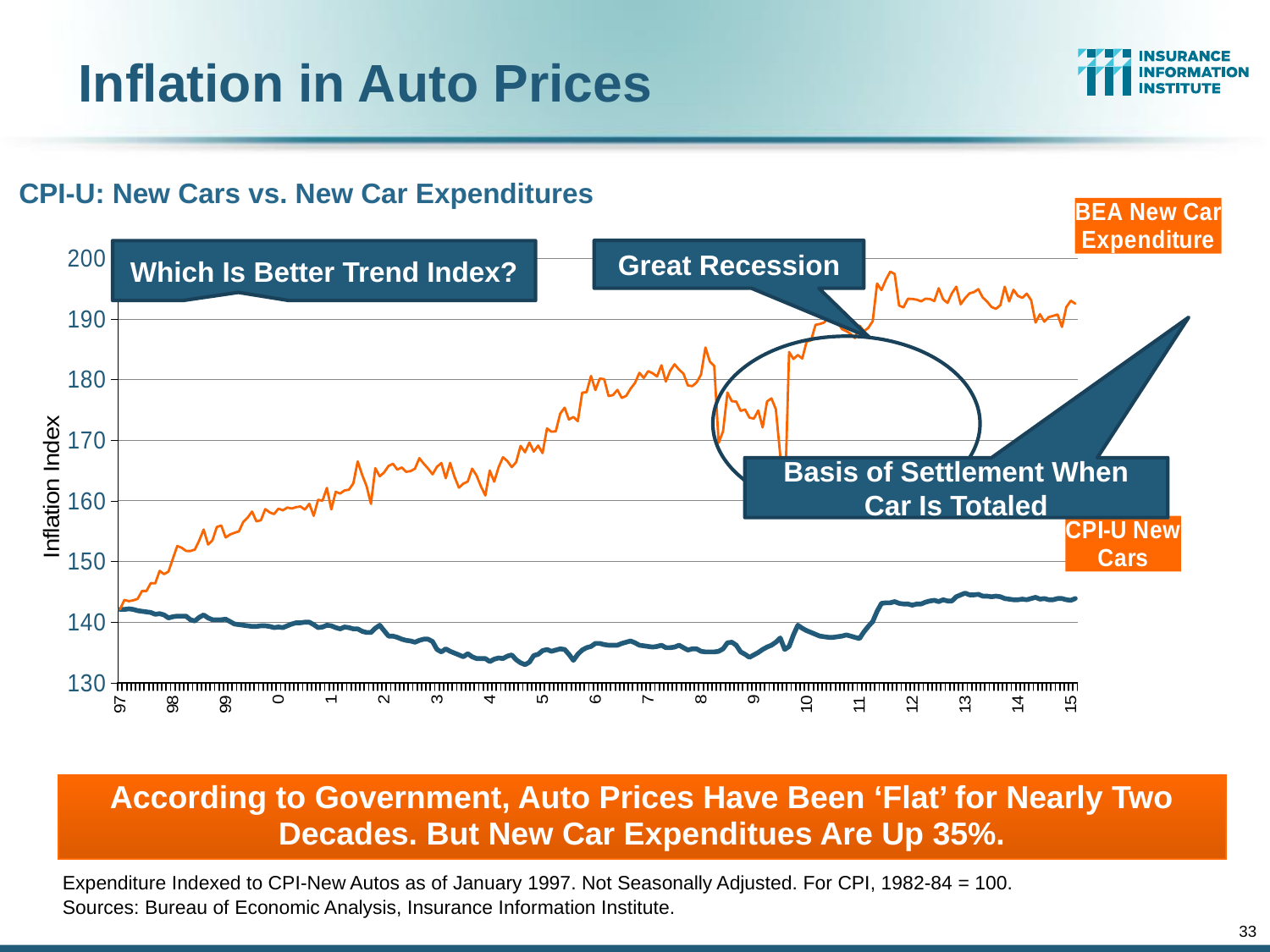
What kind of chart is shown on the slide? Line chart Does the BEA New Car Expenditure series generally rise or fall from 1997 to 2015? Rise Is the value of CPI-U New Cars in 2013 greater or less than 140? greater Is the value of BEA New Car Expenditure in 2014 greater or less than 180? greater What is the title of the chart? CPI-U: New Cars vs. New Car Expenditures Is the value of BEA New Car Expenditure in 2007 greater or less than 170? greater Which series has the higher value in 2014, BEA New Car Expenditure or CPI-U New Cars? BEA New Car Expenditure Which series is plotted in blue? CPI-U New Cars What is the label on the vertical axis of the chart? Inflation Index How many data series are plotted on the chart? 2